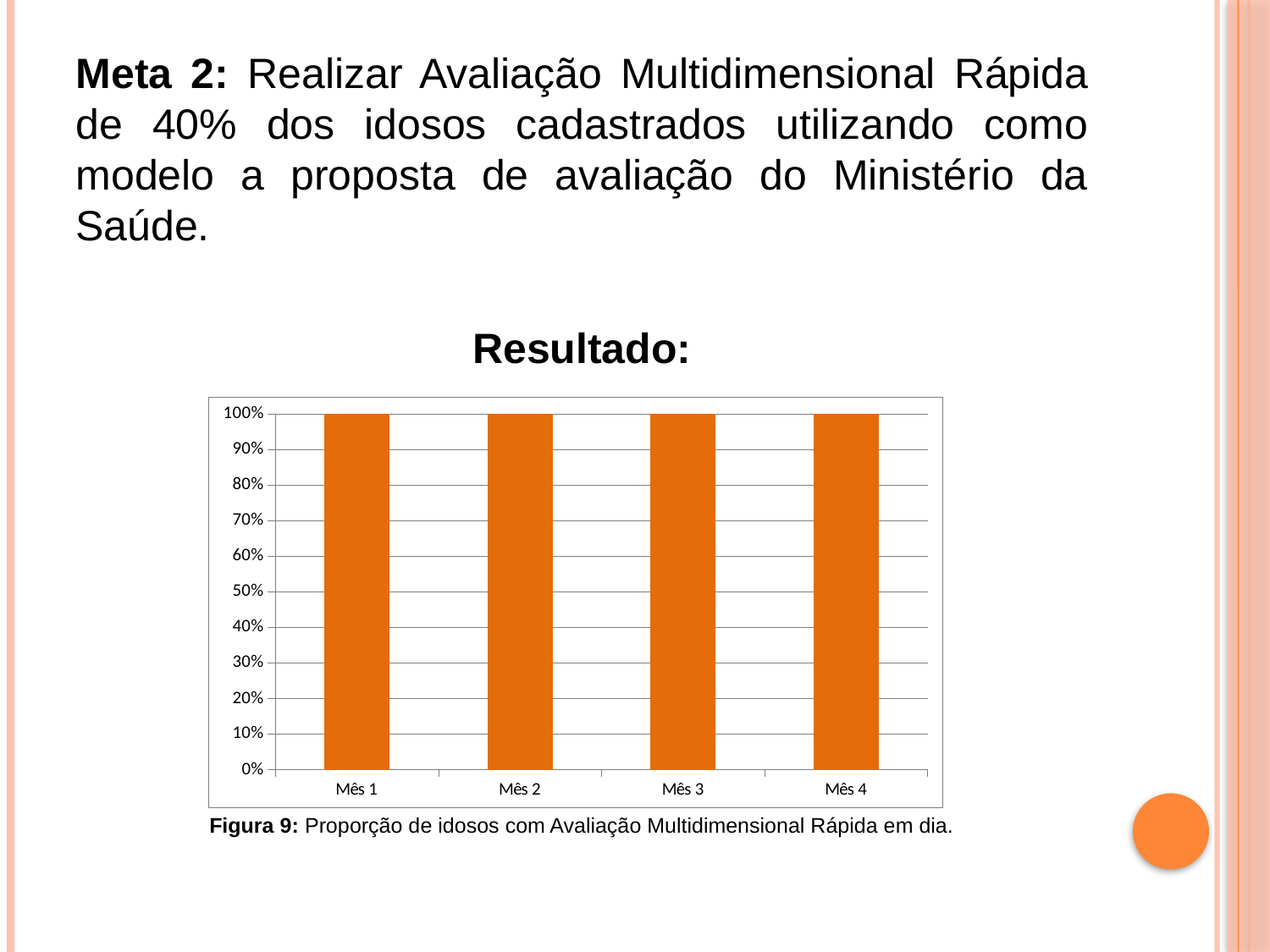
What is the value for Mês 3? 100% Do the values rise, fall, or stay the same from Mês 1 to Mês 4? Stay the same What is the value for Mês 1? 100% What kind of chart is shown on the slide? Bar chart What is the highest value shown on the y axis? 100% What is the value for Mês 4? 100% What is the difference between the values for Mês 1 and Mês 4? 0% Is the value for Mês 2 greater or less than 50%? greater How many months (categories) are shown on the x axis? 4 Is the value for Mês 4 greater or less than 90%? greater What colour are the bars in the chart? Orange